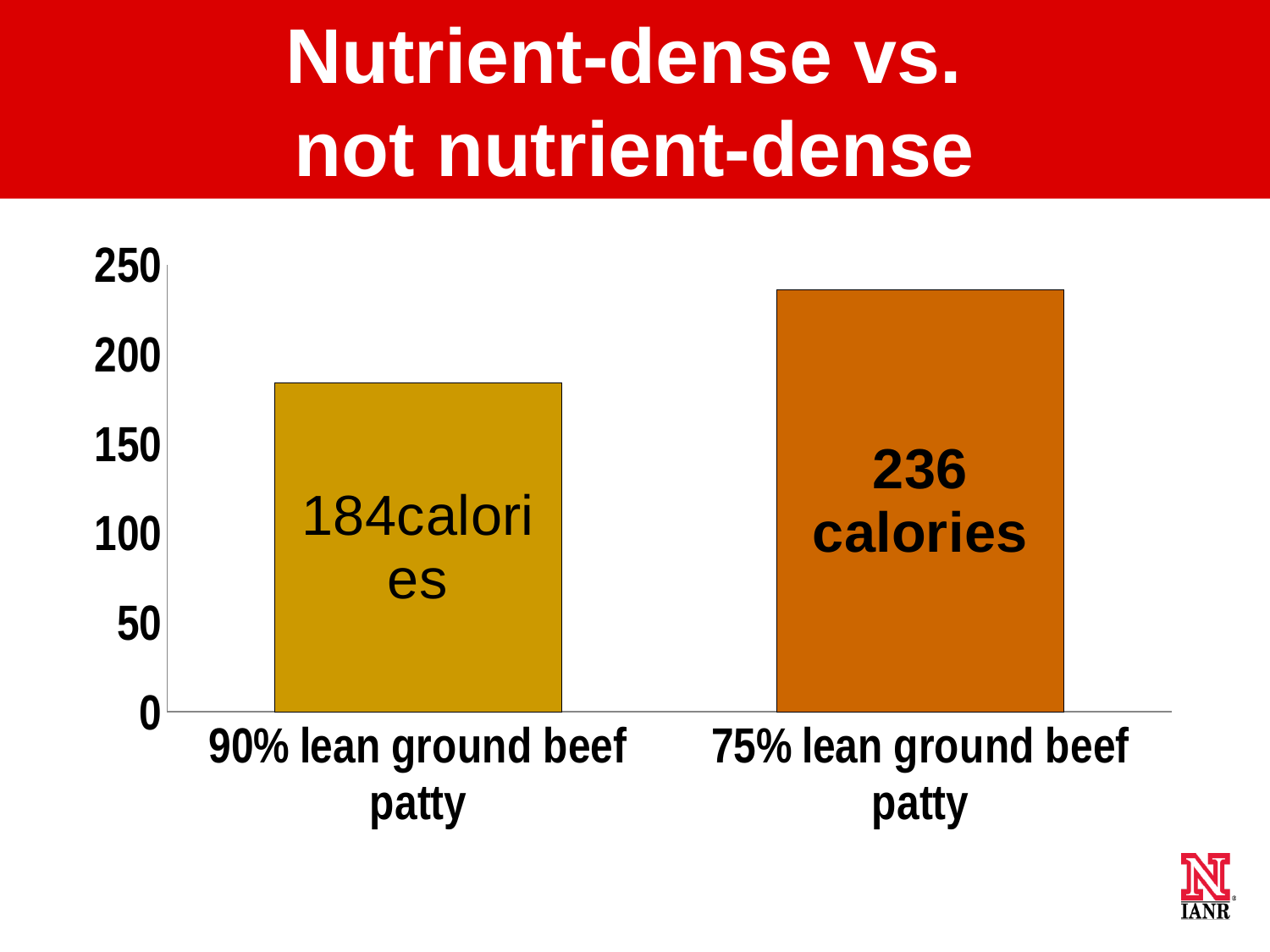
What is the highest value shown on the vertical axis? 250 How many calories does the 90% lean ground beef patty have? 184 calories Is the value for the 90% lean ground beef patty greater or less than 200? less What kind of chart is shown on the slide? Bar chart How many calories does the 75% lean ground beef patty have? 236 calories Is the value for the 75% lean ground beef patty greater or less than 200? greater What is the difference in calories between the 75% lean and the 90% lean ground beef patty? 52 calories Which patty has the lower calorie value? 90% lean ground beef patty What is the title of the slide? Nutrient-dense vs. not nutrient-dense Which patty has the higher calorie value? 75% lean ground beef patty How many categories are shown on the chart? 2